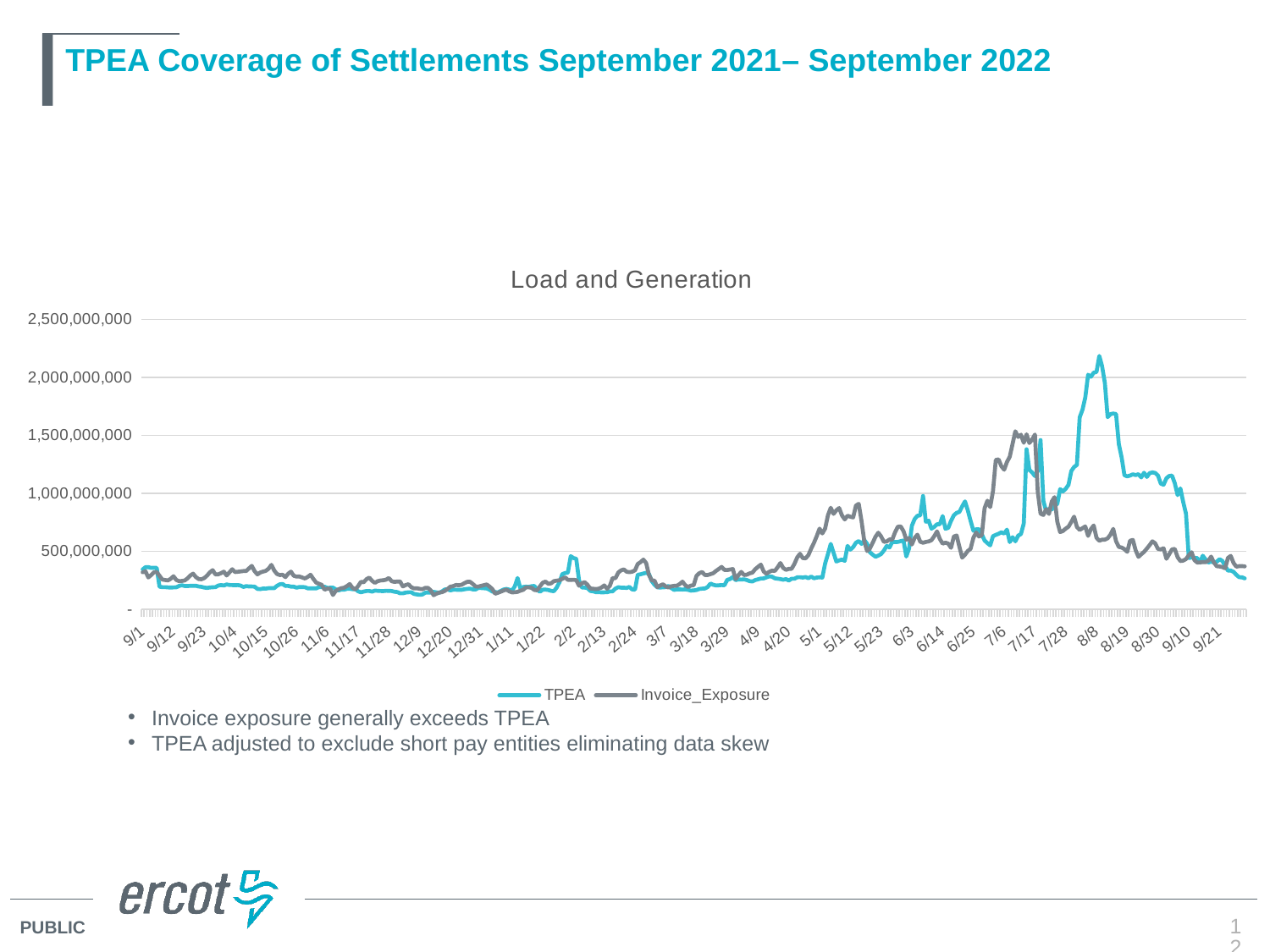
What is the title of the chart? Load and Generation Which series is drawn in gray in the chart? Invoice_Exposure Is the value of TPEA at 9/21 greater or less than 500,000,000? less Around 8/8, which series has the larger value, TPEA or Invoice_Exposure? TPEA What is the highest value shown on the vertical axis? 2,500,000,000 Which series reaches the highest value anywhere on the chart? TPEA Around 7/6, which series has the larger value, TPEA or Invoice_Exposure? Invoice_Exposure Is the value of Invoice_Exposure at 11/6 greater or less than 500,000,000? less Is the peak value of Invoice_Exposure around 7/6 greater or less than 1,000,000,000? greater What kind of chart is shown on the slide? Line chart How many series does the legend list? 2